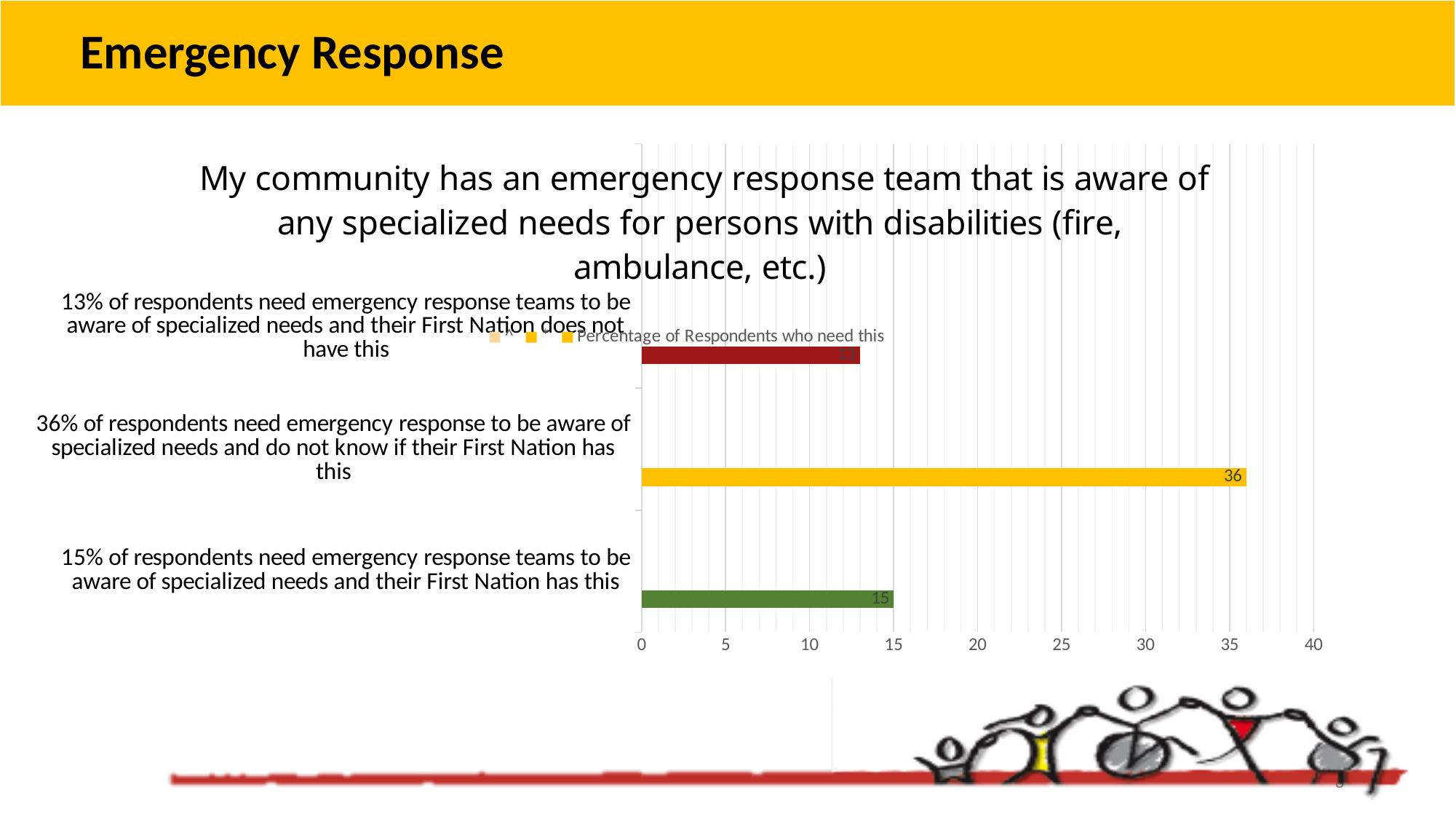
What is the difference between the value for those whose First Nation has this and the value for those whose First Nation does not have this? 2 Which category has the lowest value? 13% of respondents need emergency response teams to be aware of specialized needs and their First Nation does not have this Is the value for those who do not know if their First Nation has this greater or less than 30? greater What is the difference between the value for those who do not know if their First Nation has this and the value for those whose First Nation has this? 21 What kind of chart is shown on the slide? bar chart Which is larger: the value for those whose First Nation has this or the value for those whose First Nation does not have this? their First Nation has this Which category has the highest value? 36% of respondents need emergency response to be aware of specialized needs and do not know if their First Nation has this How many categories (bars) are shown in the chart? 3 What colour is the bar for respondents who do not know if their First Nation has this? yellow What is the value for respondents who do not know if their First Nation has an emergency response team aware of specialized needs? 36 What is the value for respondents whose First Nation does not have an emergency response team aware of specialized needs? 13 What is the value for respondents whose First Nation has an emergency response team aware of specialized needs? 15